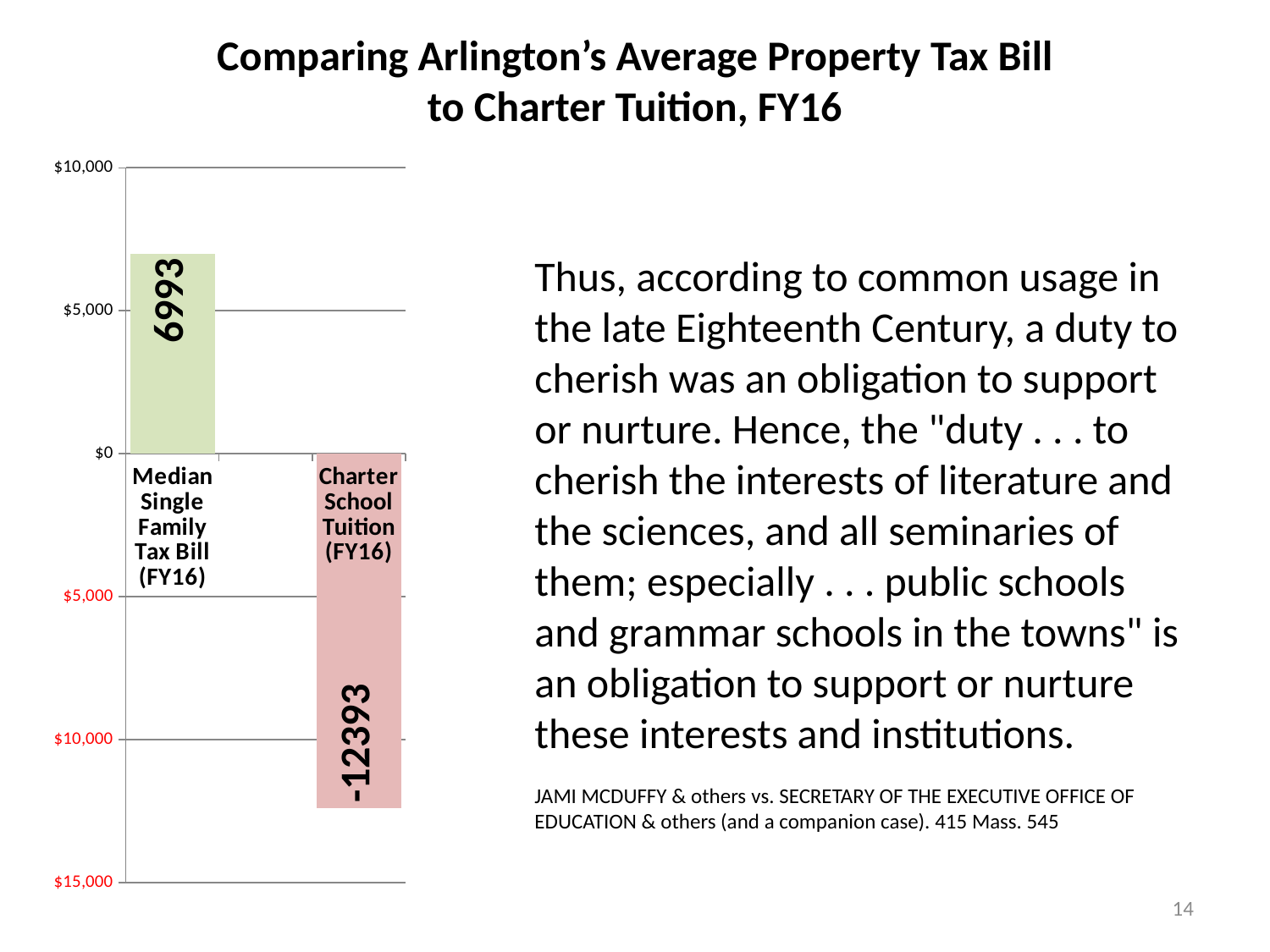
What is the title of the chart? Comparing Arlington's Average Property Tax Bill to Charter Tuition, FY16 Is the value for Median Single Family Tax Bill (FY16) greater or less than $5,000? greater Which category has the highest value? Median Single Family Tax Bill (FY16) What colour is the Charter School Tuition (FY16) bar? Pink What is the value shown for Charter School Tuition (FY16)? -12393 What kind of chart is shown on the slide? Bar chart Which category has the lowest value? Charter School Tuition (FY16) What is the difference between the Median Single Family Tax Bill (FY16) value and the Charter School Tuition (FY16) value? 19386 Which bar is larger in magnitude, Median Single Family Tax Bill (FY16) or Charter School Tuition (FY16)? Charter School Tuition (FY16) What is the value shown for Median Single Family Tax Bill (FY16)? 6993 By how much does the magnitude of the Charter School Tuition (FY16) value exceed the Median Single Family Tax Bill (FY16) value? 5400 How many categories are plotted in the chart? 2